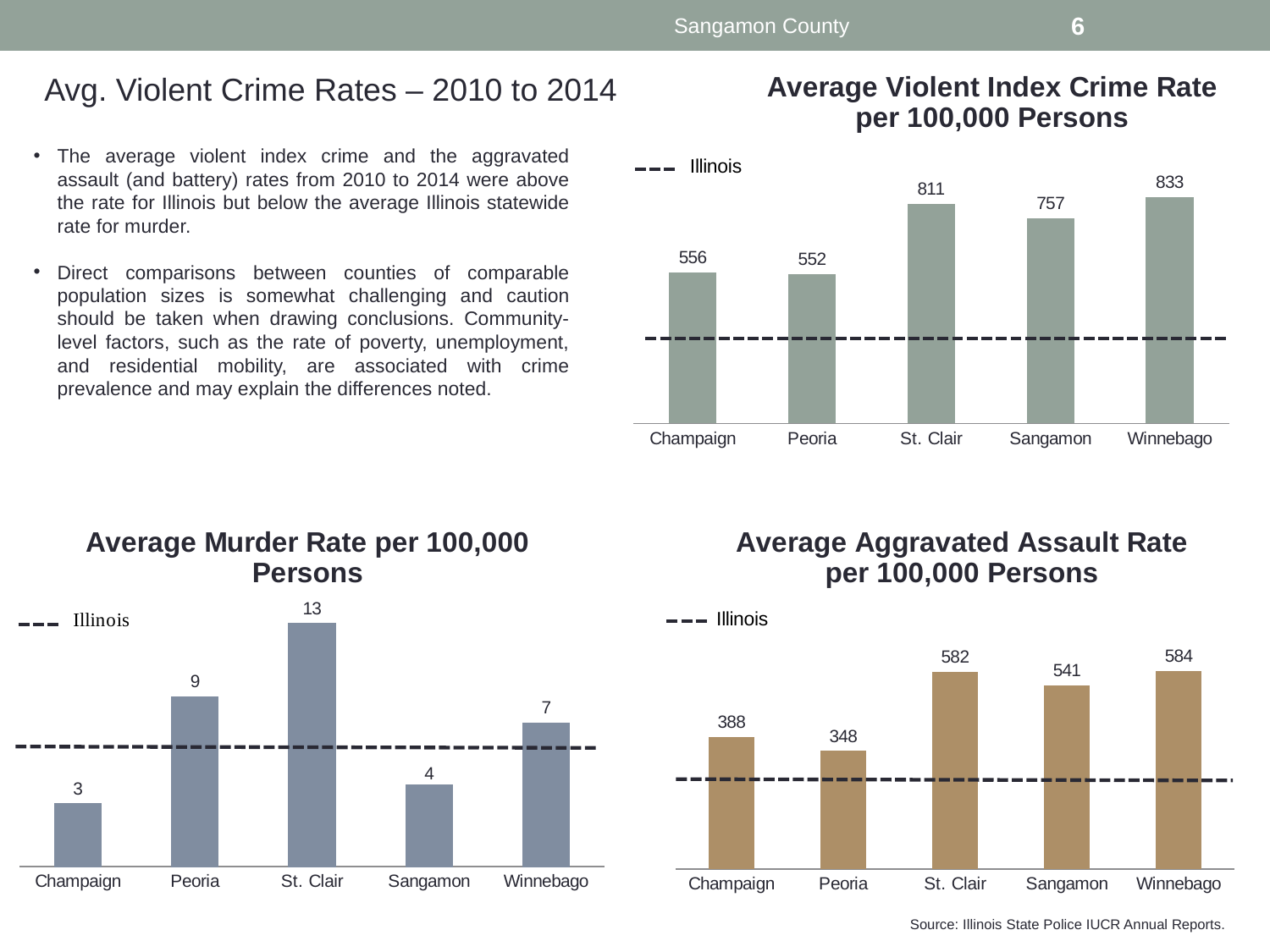
In the Average Aggravated Assault Rate per 100,000 Persons chart, which county has the lowest rate? Peoria In the Average Violent Index Crime Rate per 100,000 Persons chart, what is the value for Sangamon? 757 In the Average Murder Rate per 100,000 Persons chart, which county has the lowest rate? Champaign What kind of chart is the Average Aggravated Assault Rate per 100,000 Persons chart? Bar chart In the Average Aggravated Assault Rate per 100,000 Persons chart, what is the difference between Sangamon and Champaign? 153 What does the dashed line in the Average Violent Index Crime Rate per 100,000 Persons chart represent, according to the legend? Illinois In the Average Murder Rate per 100,000 Persons chart, which is larger, Peoria or Winnebago? Peoria In the Average Aggravated Assault Rate per 100,000 Persons chart, what is the value for Peoria? 348 How many counties are shown in the Average Murder Rate per 100,000 Persons chart? 5 In the Average Violent Index Crime Rate per 100,000 Persons chart, which county has the highest rate? Winnebago In the Average Murder Rate per 100,000 Persons chart, what is the value for St. Clair? 13 In the Average Violent Index Crime Rate per 100,000 Persons chart, what is the difference between St. Clair and Champaign? 255